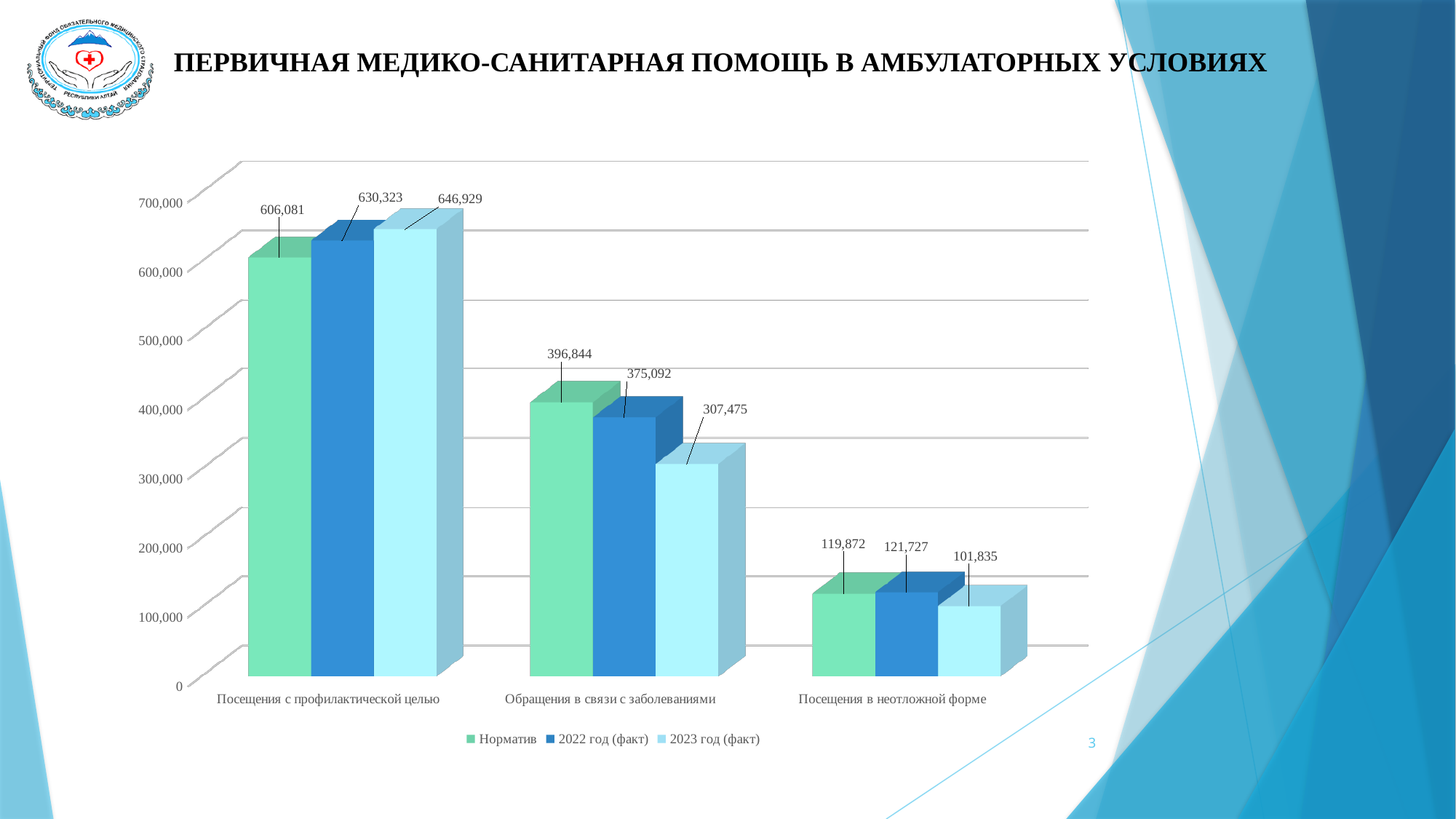
What is the difference between the 2023 год (факт) value and the Норматив value for Посещения с профилактической целью? 40,848 Which category has the lowest 2023 год (факт) value? Посещения в неотложной форме How many categories are shown on the x axis of the chart? 3 What is the Норматив value for Обращения в связи с заболеваниями? 396,844 Which category has the highest Норматив value? Посещения с профилактической целью How many series does the chart legend list? 3 What kind of chart is shown on the slide? Bar chart What is the value of the 2023 год (факт) series for Посещения с профилактической целью? 646,929 What is the difference between the Норматив value and the 2023 год (факт) value for Обращения в связи с заболеваниями? 89,369 For Обращения в связи с заболеваниями, which is larger: the 2022 год (факт) value or the 2023 год (факт) value? 2022 год (факт) Is the 2022 год (факт) value for Обращения в связи с заболеваниями greater or less than 400,000? less What is the 2022 год (факт) value for Посещения в неотложной форме? 121,727